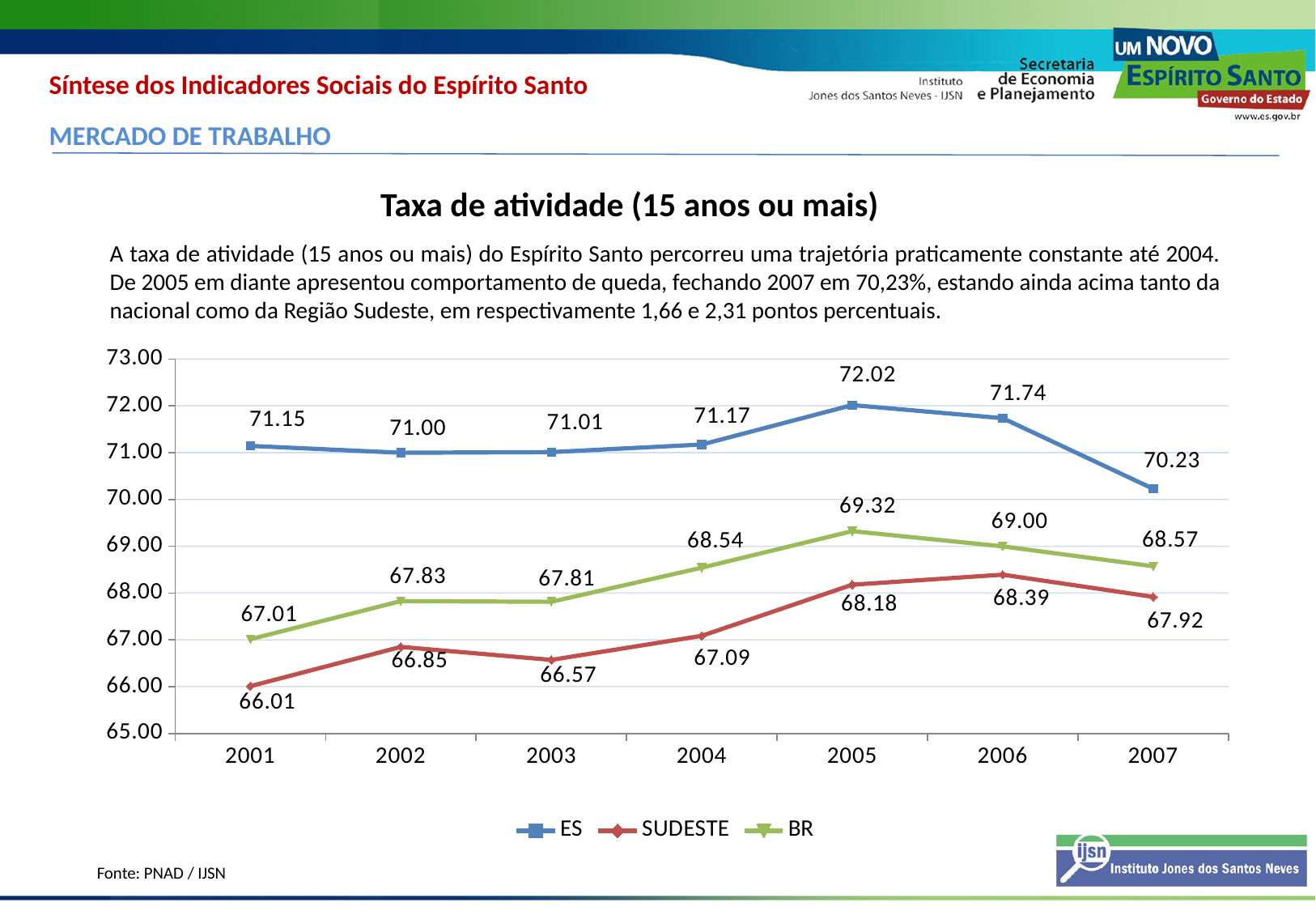
How many years are shown on the x axis? 7 What is the title of the chart? Taxa de atividade (15 anos ou mais) What is the difference between the ES value and the BR value in 2007? 1.66 What is the value for SUDESTE in 2001? 66.01 In which year does the ES series reach its highest value? 2005 In which year does the SUDESTE series have its lowest value? 2001 What is the value for ES in 2007? 70.23 Which series has the higher value in 2004, SUDESTE or BR? BR Does the ES series rise or fall from 2005 to 2007? fall What type of chart is shown on the slide? line chart What is the value for BR in 2005? 69.32 How many series does the legend list? 3